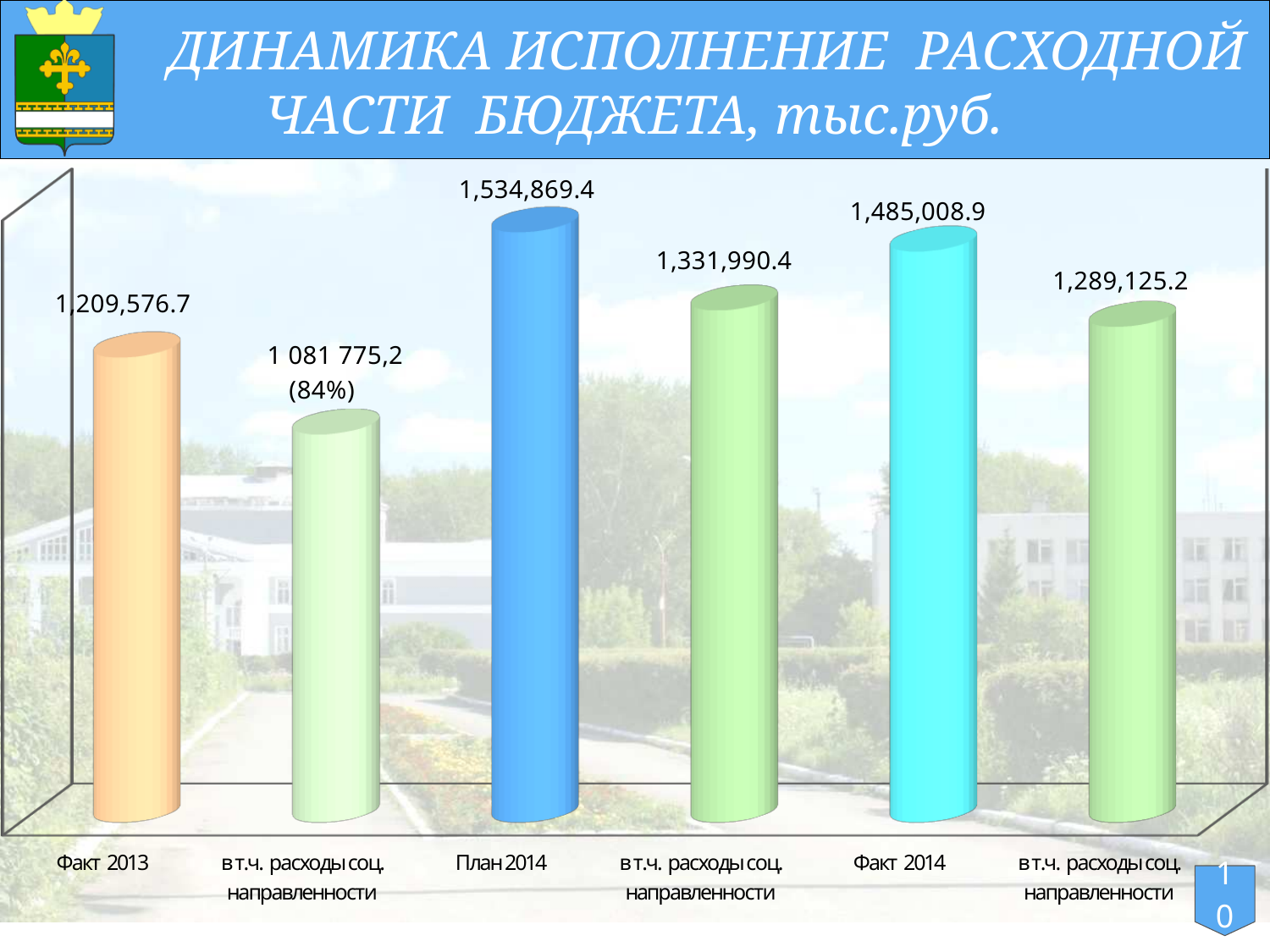
What is the value of the в т.ч. расходы соц. направленности bar that follows План 2014? 1,331,990.4 Which category has the highest value? План 2014 Which is larger, Факт 2013 or Факт 2014? Факт 2014 How many bars are shown in the chart? 6 What is the value for Факт 2014? 1,485,008.9 Which bar has the lowest value? в т.ч. расходы соц. направленности (second bar, after Факт 2013) What kind of chart is shown on the slide? bar chart What is the value for Факт 2013? 1,209,576.7 What is the value of the last bar (в т.ч. расходы соц. направленности, following Факт 2014)? 1,289,125.2 What is the value of the second bar (в т.ч. расходы соц. направленности, following Факт 2013)? 1 081 775,2 (84%) What is the value for План 2014? 1,534,869.4 What is the difference between План 2014 and Факт 2014? 49,860.5